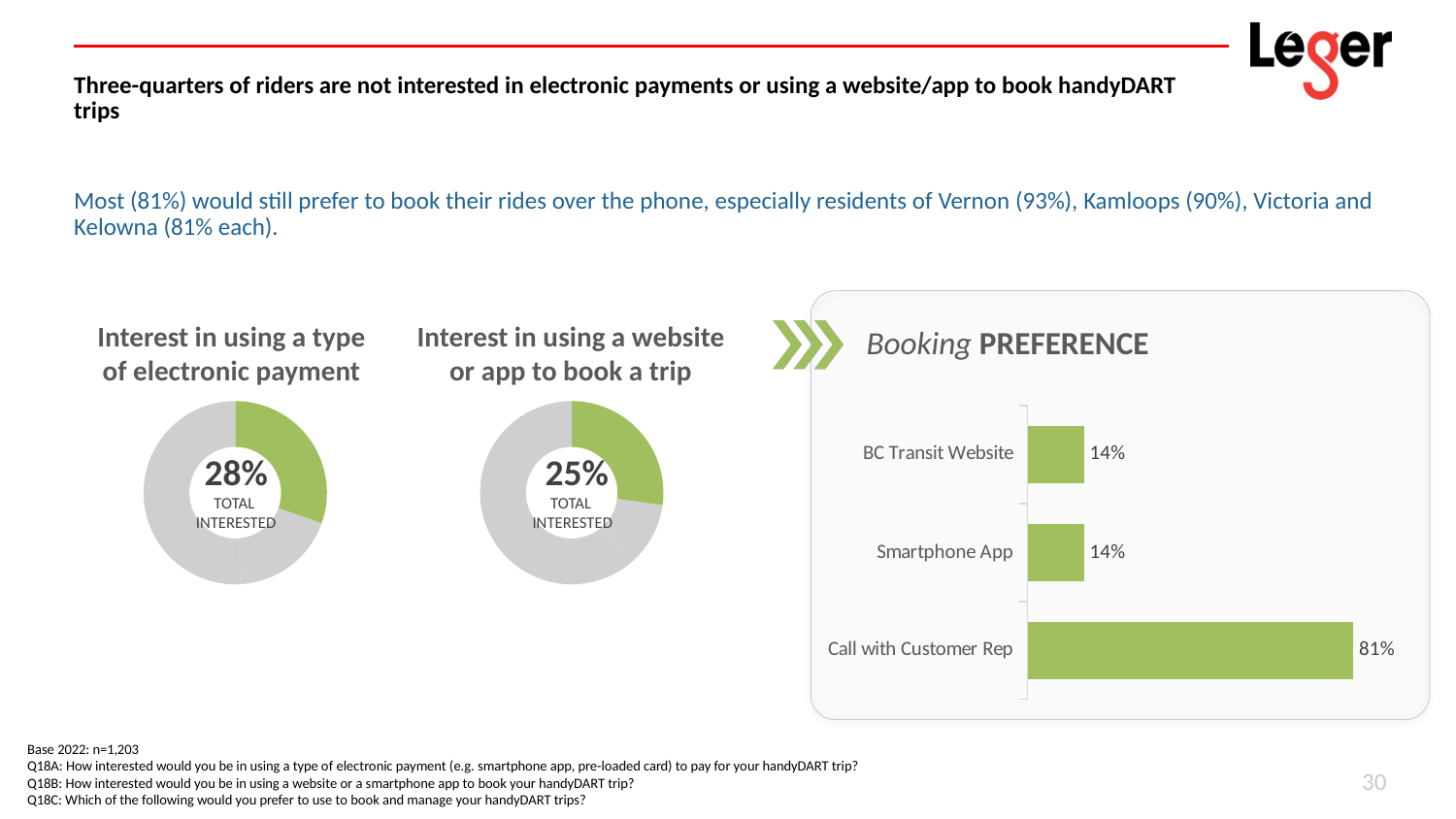
What kind of chart is the Booking Preference chart? Bar chart In the Booking Preference chart, what is the value for BC Transit Website? 14% In the chart titled 'Interest in using a type of electronic payment', what percentage is total interested? 28% In the Booking Preference chart, what is the value for Smartphone App? 14% In the Booking Preference chart, which booking option has the highest value? Call with Customer Rep Which of the two donut charts shows a higher total interested percentage: electronic payment or website/app booking? Interest in using a type of electronic payment In the Booking Preference chart, which is larger: Call with Customer Rep or Smartphone App? Call with Customer Rep What is the difference between the total interested values in the electronic payment chart and the website or app chart? 3 percentage points In the chart titled 'Interest in using a website or app to book a trip', what percentage is total interested? 25% In the Booking Preference chart, what is the difference between Call with Customer Rep and BC Transit Website? 67 percentage points How many booking options are shown in the Booking Preference chart? 3 In the Booking Preference chart, what percentage prefer Call with Customer Rep? 81%